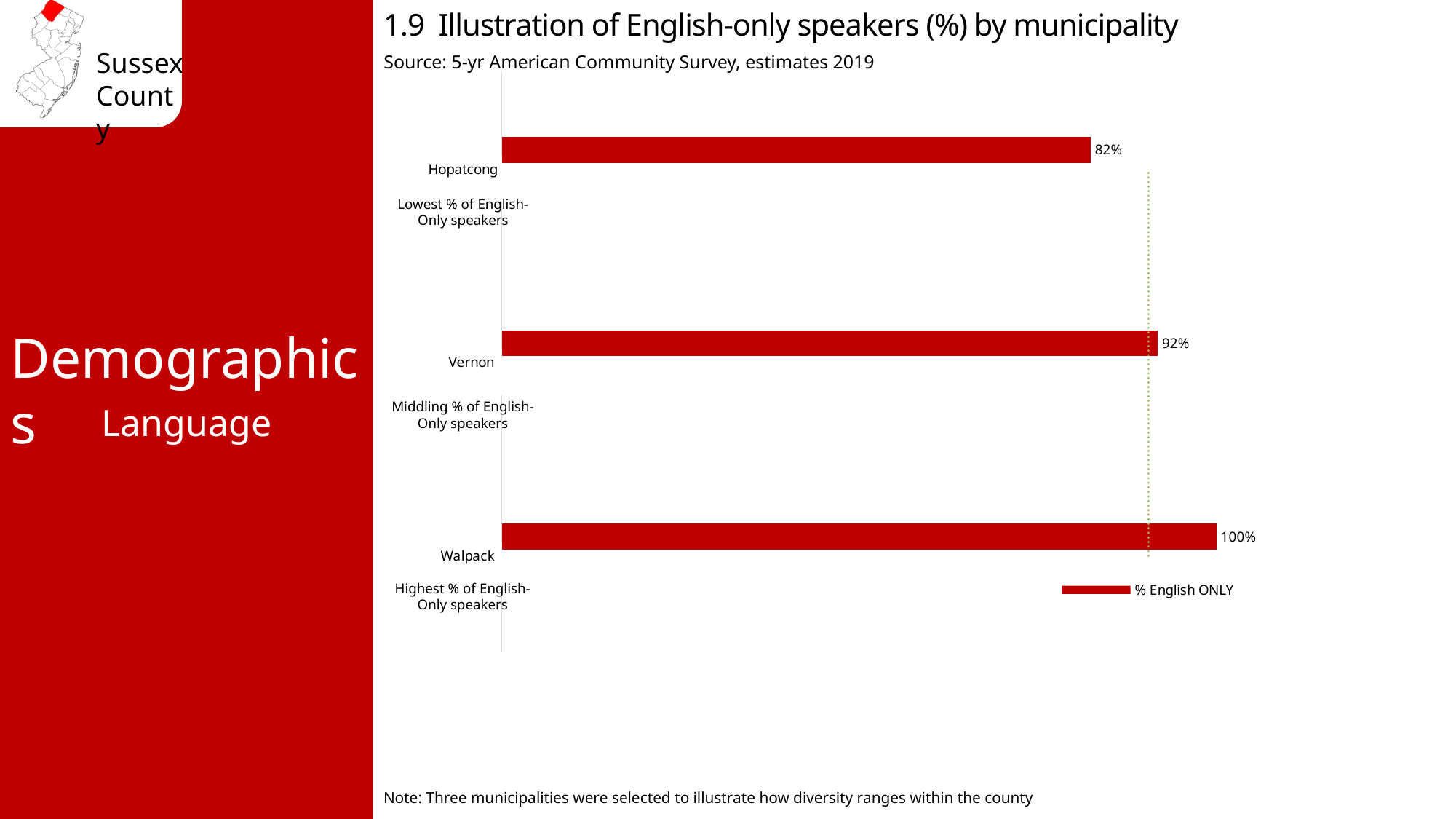
Which municipality has the lowest percentage of English-only speakers? Hopatcong What is the percentage of English-only speakers in Vernon? 92% Which has a higher percentage of English-only speakers, Vernon or Hopatcong? Vernon What kind of chart is shown on the slide? Bar chart How many municipalities are shown in the chart? 3 Which municipality has the highest percentage of English-only speakers? Walpack What is the legend entry for the series in the chart? % English ONLY What is the percentage of English-only speakers in Hopatcong? 82% What is the difference in percentage points between Walpack and Hopatcong? 18 What is the percentage of English-only speakers in Walpack? 100% What is the difference in percentage points between Vernon and Hopatcong? 10 How many series does the legend list? 1